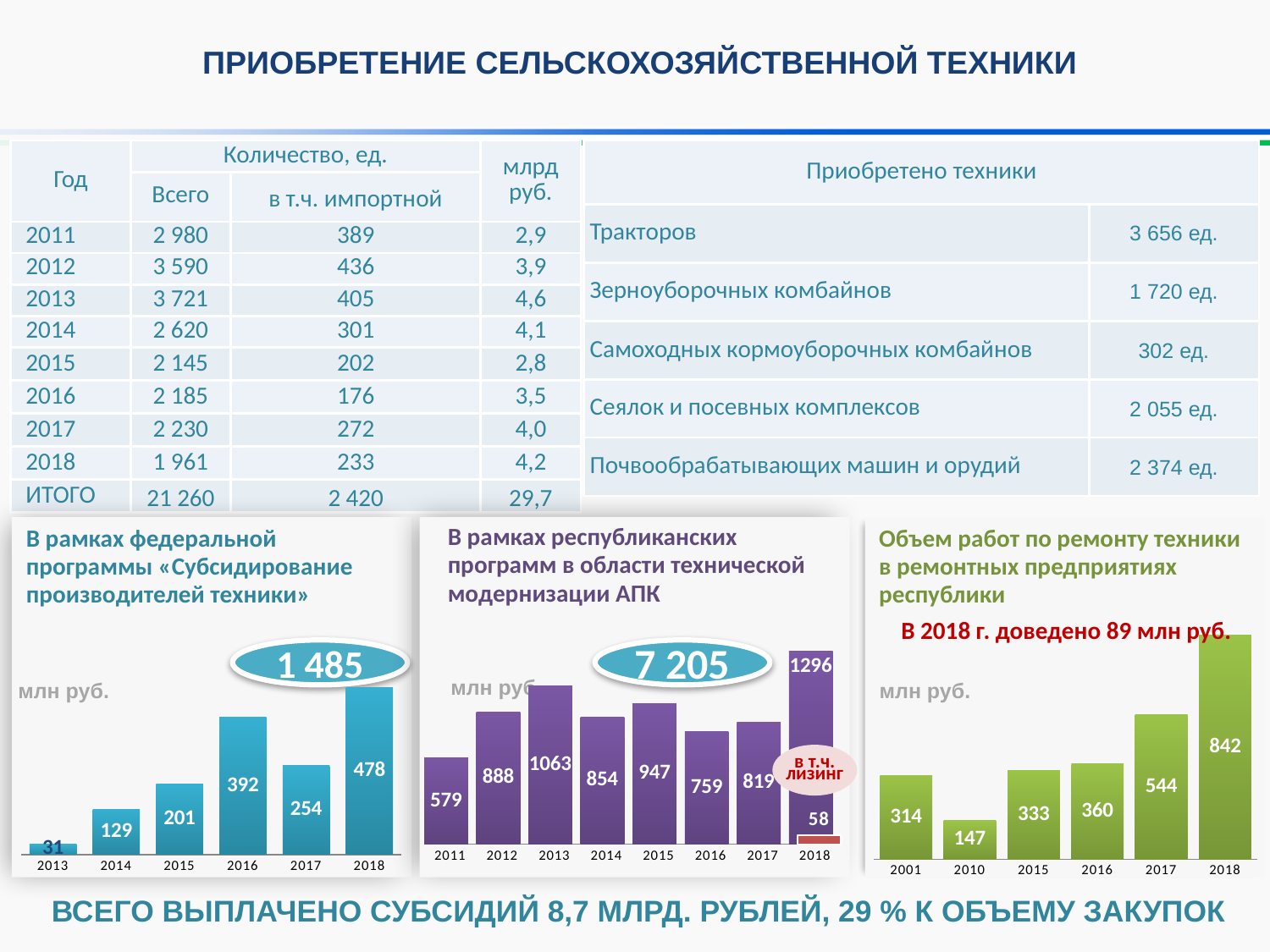
In the left chart (federal programme «Субсидирование производителей техники»), which year has the highest value? 2018 In the middle chart (republican programmes for technical modernisation of the agro-industrial complex), what is the leasing (в т.ч. лизинг) value shown for 2018? 58 In the middle chart (republican programmes for technical modernisation of the agro-industrial complex), which year has the highest value? 2018 In the left chart (federal programme «Субсидирование производителей техники»), what is the difference between the values for 2018 and 2017? 224 In the left chart (federal programme «Субсидирование производителей техники»), which year has the lowest value? 2013 In the middle chart (republican programmes for technical modernisation of the agro-industrial complex), which is larger, the value for 2013 or the value for 2014? 2013 In the right chart (volume of repair work at repair enterprises of the republic), which year has the lowest value? 2010 In the left chart (federal programme «Субсидирование производителей техники»), what is the value for 2016? 392 In the right chart (volume of repair work at repair enterprises of the republic), what is the value for 2017? 544 What kind of chart is the right chart (volume of repair work at repair enterprises of the republic)? bar chart In the left chart (federal programme «Субсидирование производителей техники»), how many years are plotted? 6 In the middle chart (republican programmes for technical modernisation of the agro-industrial complex), what is the value for 2015? 947